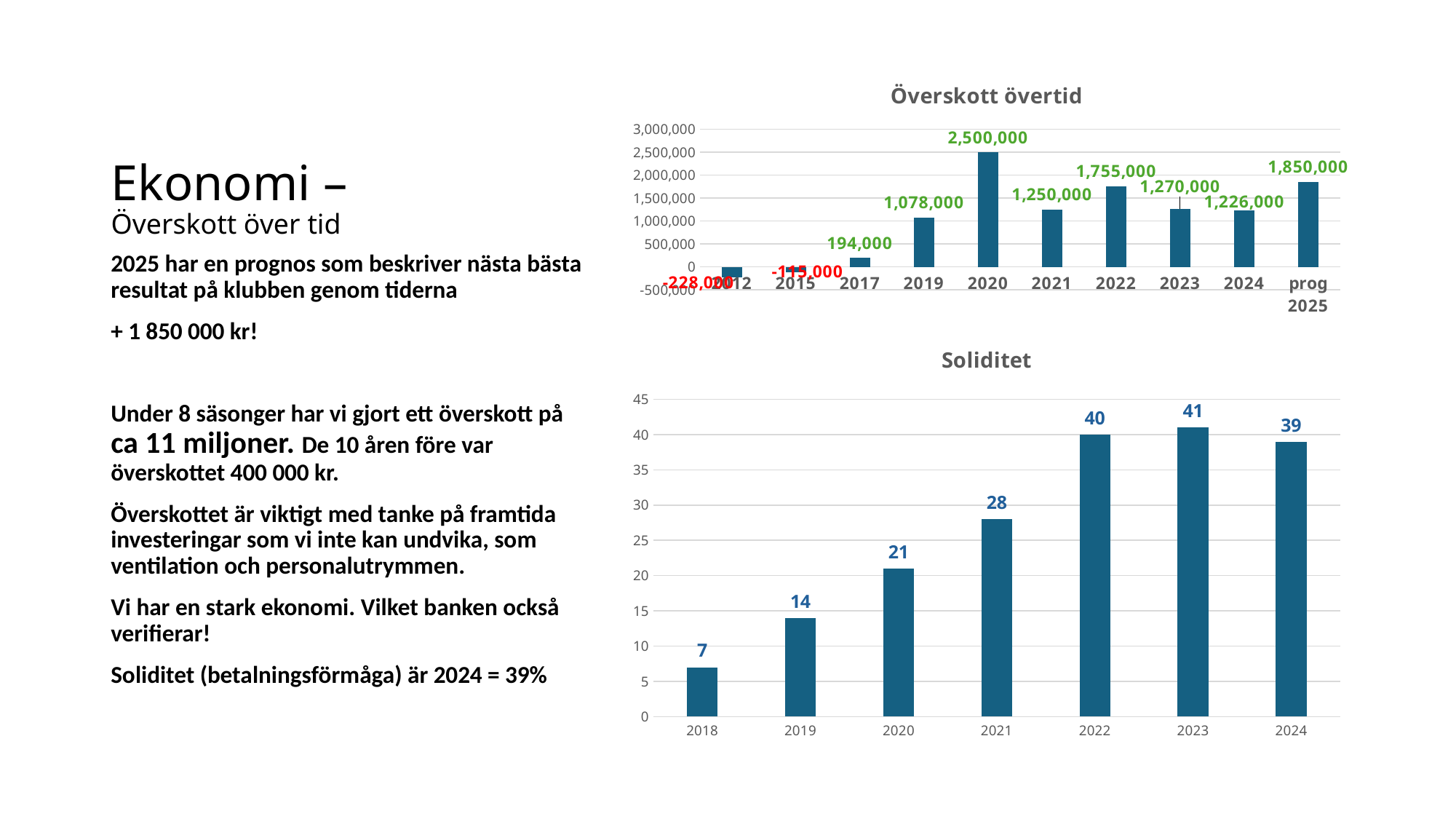
In the 'Överskott övertid' chart, which year has the highest value? 2020 In the 'Överskott övertid' chart, what is the value for 2020? 2,500,000 In the 'Överskott övertid' chart, what is the value for prog 2025? 1,850,000 In the 'Soliditet' chart, which year has the lowest value? 2018 In the 'Överskott övertid' chart, what is the difference between the values for 2022 and 2021? 505,000 In the 'Soliditet' chart, what is the value for 2021? 28 In the 'Överskott övertid' chart, how many categories are shown on the x axis? 10 In the 'Soliditet' chart, is the value for 2020 larger or smaller than the value for 2024? smaller In the 'Överskott övertid' chart, which year has the lowest value? 2012 What kind of chart is the 'Soliditet' chart? bar chart In the 'Soliditet' chart, which year has the highest value? 2023 In the 'Soliditet' chart, what is the difference between the values for 2022 and 2019? 26